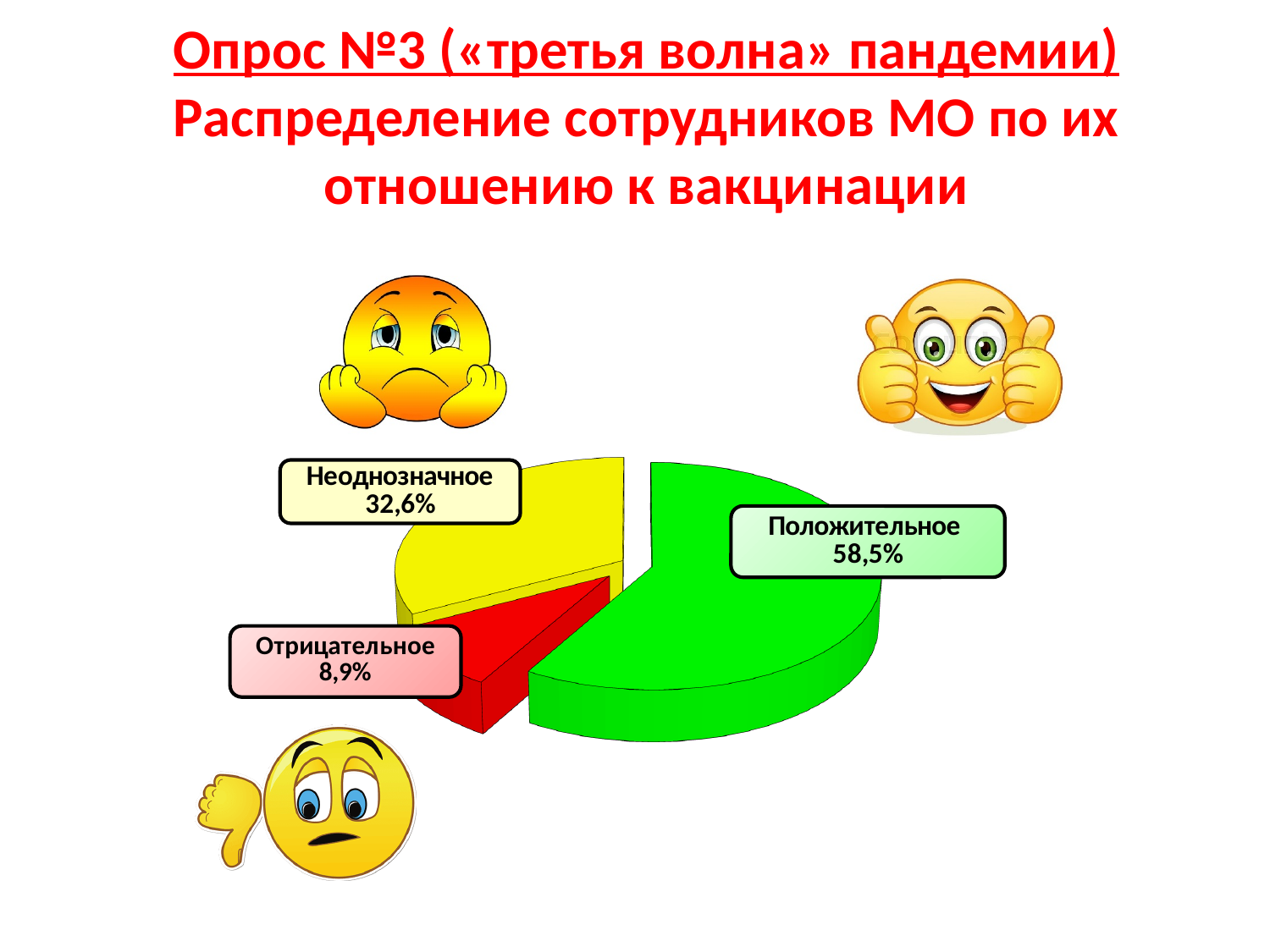
What kind of chart is shown on the slide? Pie chart How many categories does the pie chart show? 3 What colour is the slice for Отрицательное? Red Which is larger: the share for Неоднозначное or the share for Отрицательное? Неоднозначное Which attitude category has the largest share of the pie? Положительное What share of employees have an ambiguous (Неоднозначное) attitude to vaccination? 32,6% What share of employees have a negative (Отрицательное) attitude to vaccination? 8,9% Which attitude category has the smallest share of the pie? Отрицательное What share of employees have a positive (Положительное) attitude to vaccination? 58,5% What is the difference in percentage points between the Неоднозначное and Отрицательное shares? 23,7 What is the difference in percentage points between the Положительное and Неоднозначное shares? 25,9 What colour is the slice for Положительное? Green